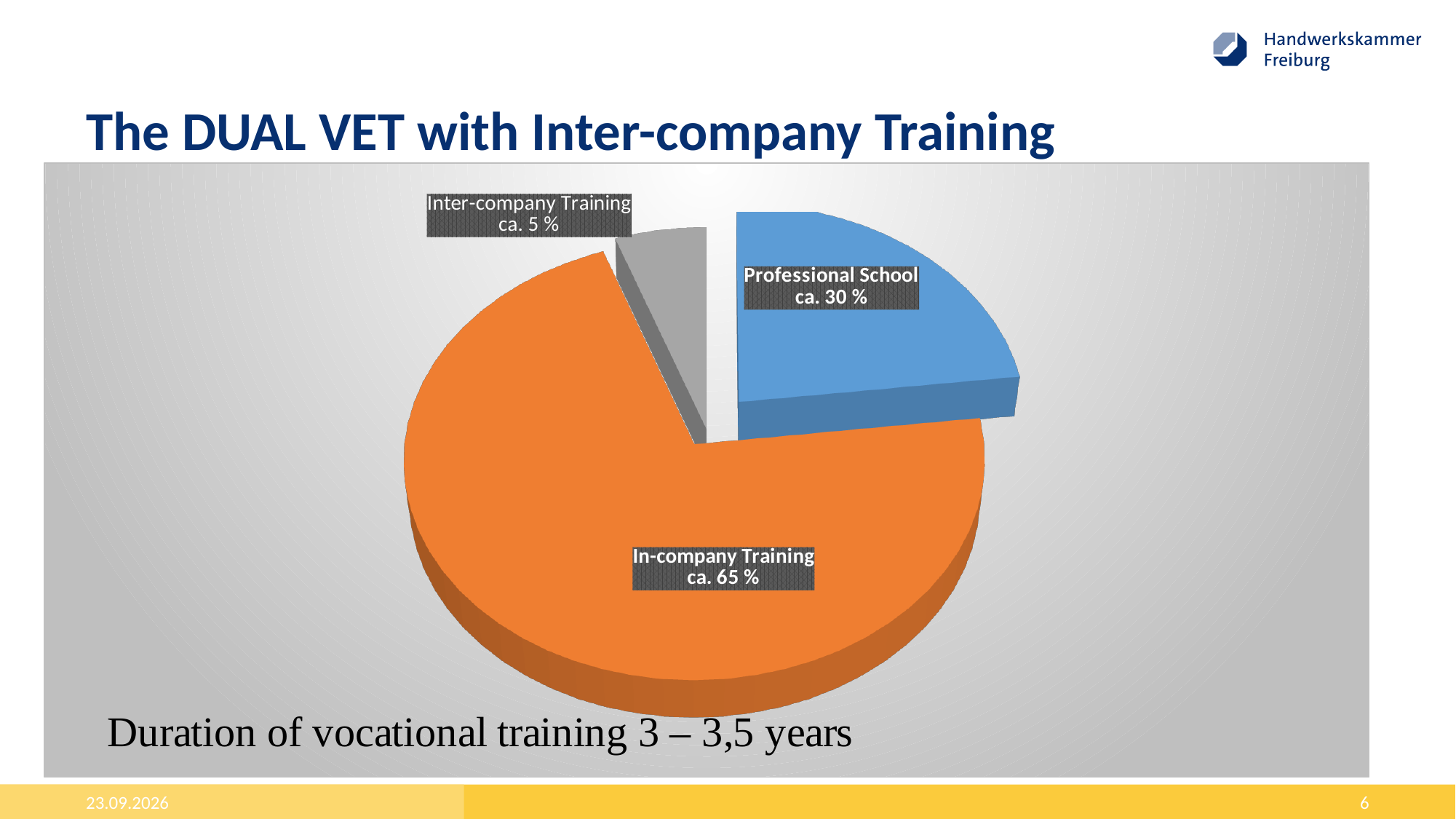
What kind of chart is shown on the slide? Pie chart What colour is the Professional School slice? Blue How many slices does the pie chart have? 3 What share of the pie is labelled for In-company Training? ca. 65 % Which is larger, the Professional School slice or the Inter-company Training slice? Professional School Which is larger, the In-company Training slice or the Professional School slice? In-company Training Which slice of the pie chart is the smallest? Inter-company Training Which slice of the pie chart is the largest? In-company Training What share of the pie is labelled for Professional School? ca. 30 % What share of the pie is labelled for Inter-company Training? ca. 5 % What colour is the In-company Training slice? Orange